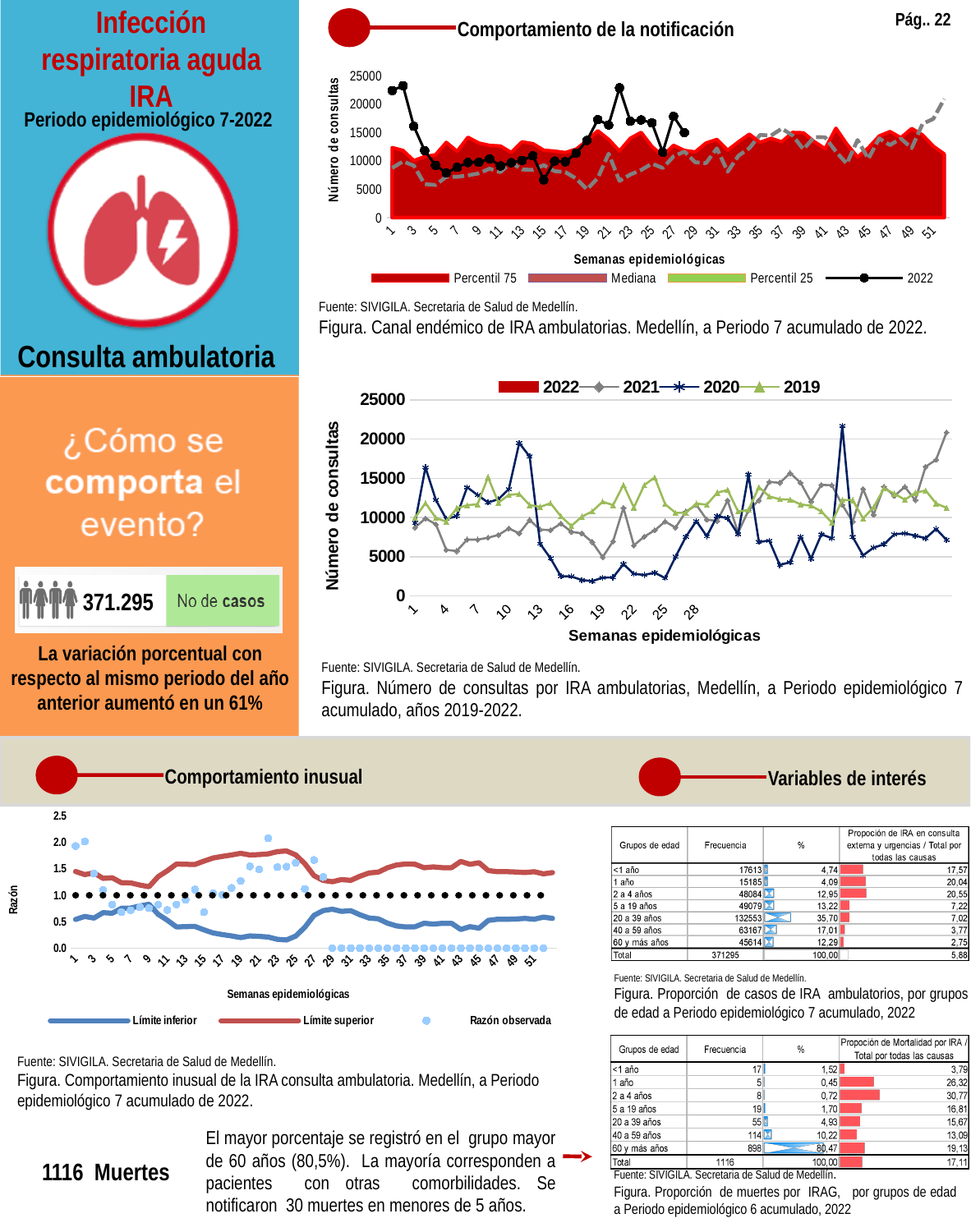
In the chart titled 'Comportamiento inusual de la IRA consulta ambulatoria', is the 'Razón observada' value at week 1 greater or less than 1.5? greater In the chart titled 'Número de consultas por IRA ambulatorias, años 2019-2022', is the 2020 value at week 10 greater or less than 15000? less In the chart titled 'Canal endémico de IRA ambulatorias', how many series does the legend list? 4 In the chart titled 'Canal endémico de IRA ambulatorias', what is the label of the y axis? Número de consultas What kind of chart is the one titled 'Número de consultas por IRA ambulatorias, años 2019-2022'? line chart In the chart titled 'Comportamiento inusual de la IRA consulta ambulatoria', is the 'Límite inferior' value at week 25 greater or less than 0.5? less In the chart titled 'Comportamiento inusual de la IRA consulta ambulatoria', how many series does the legend list? 3 In the chart titled 'Número de consultas por IRA ambulatorias, años 2019-2022', how many series does the legend list? 4 In the chart titled 'Número de consultas por IRA ambulatorias, años 2019-2022', which series is higher at week 16: 2019 or 2020? 2019